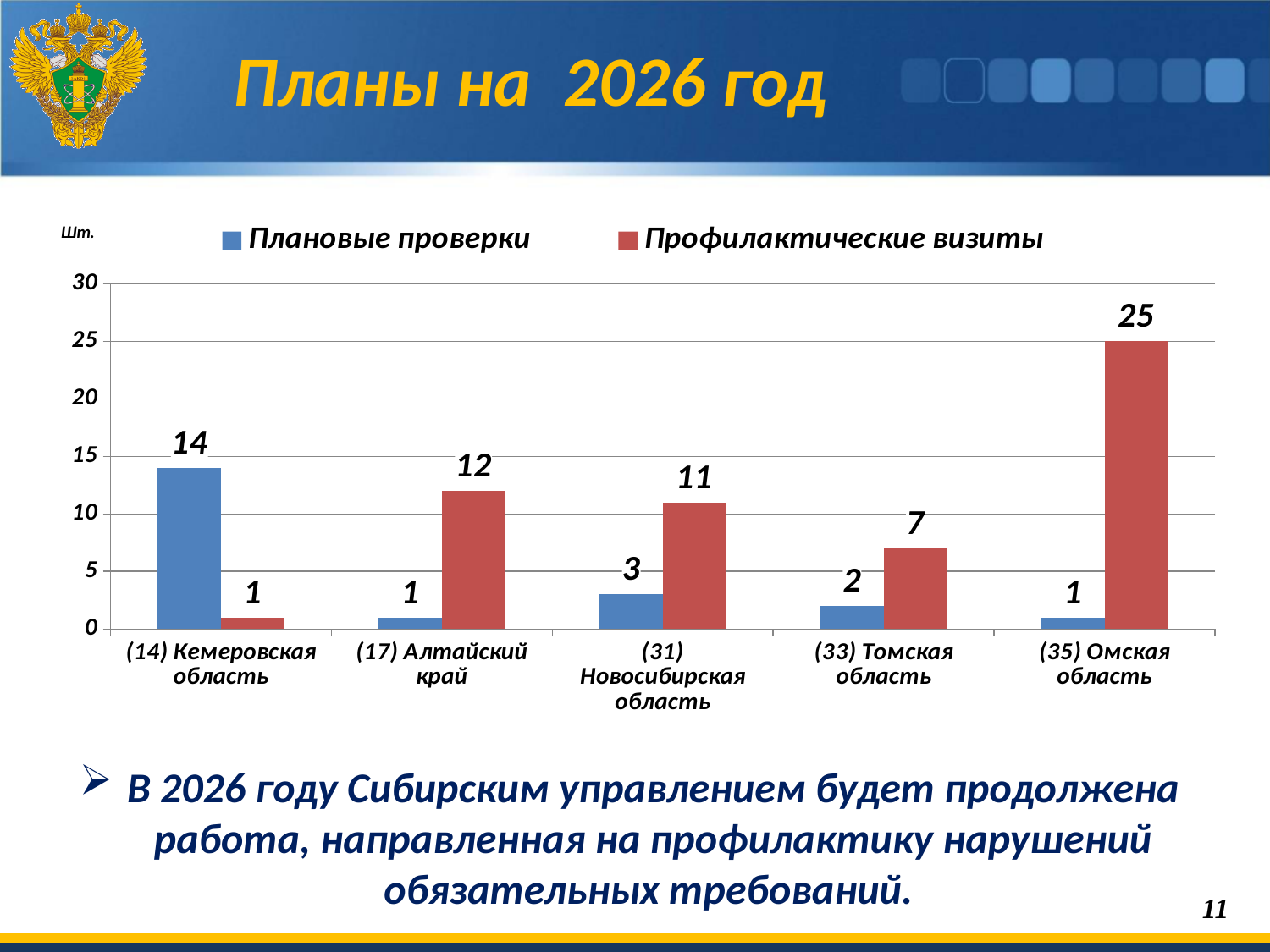
What is the value of Профилактические визиты for (35) Омская область? 25 What is the value of Плановые проверки for (14) Кемеровская область? 14 Which region has the highest value for Плановые проверки? (14) Кемеровская область Which is larger for (31) Новосибирская область: Плановые проверки or Профилактические визиты? Профилактические визиты What is the value of Плановые проверки for (33) Томская область? 2 What is the value of Профилактические визиты for (31) Новосибирская область? 11 How many regions are shown on the x axis of the chart? 5 What kind of chart is shown on the slide? Bar chart Which region has the lowest value for Профилактические визиты? (14) Кемеровская область How many series does the legend list? 2 Which region has the highest value for Профилактические визиты? (35) Омская область What is the difference between Профилактические визиты for (35) Омская область and (17) Алтайский край? 13